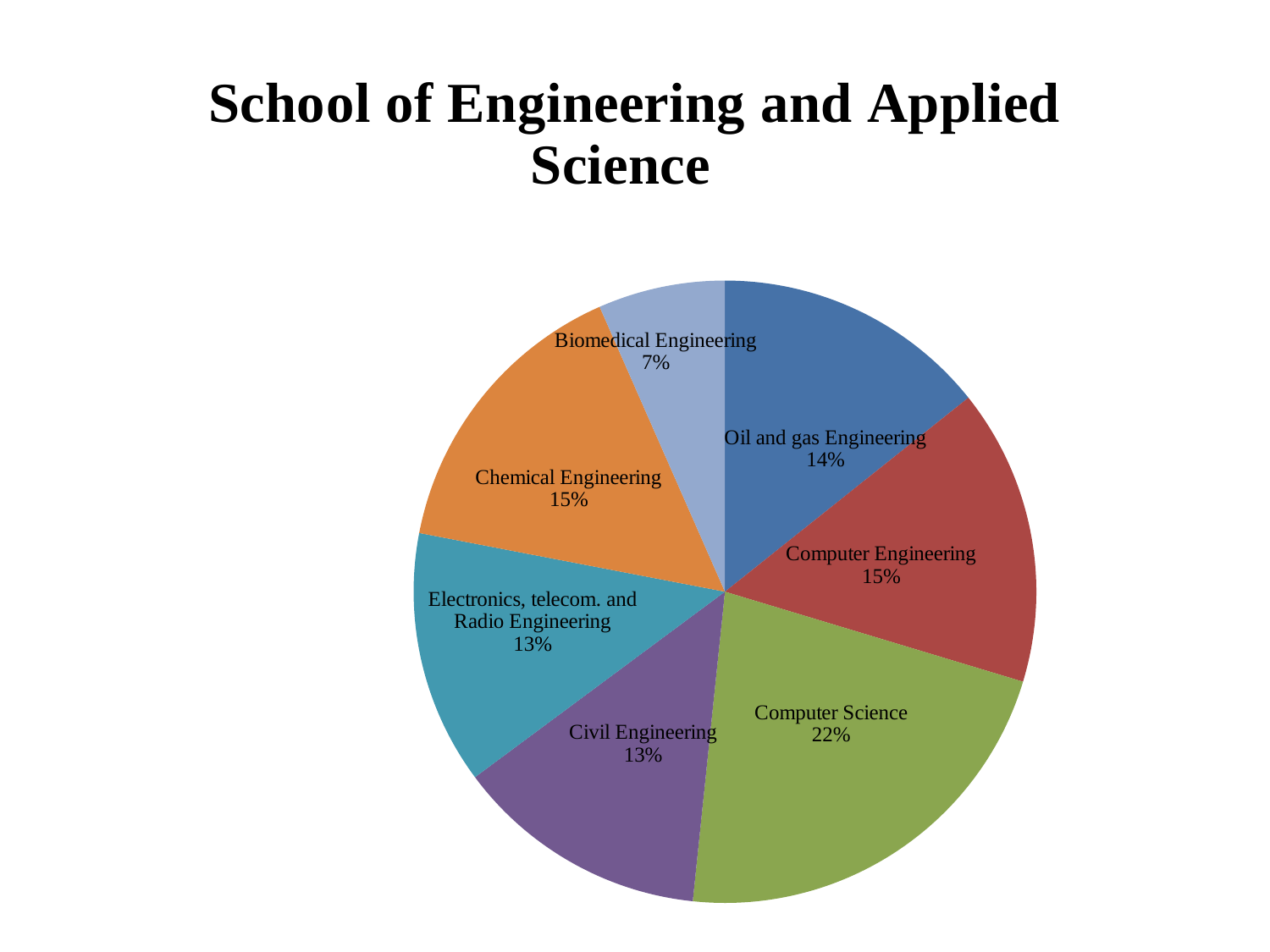
What is the title of the slide containing the chart? School of Engineering and Applied Science What is the value shown for Oil and gas Engineering? 14% What share of the pie does Computer Science hold? 22% Which is larger, the share for Computer Science or the share for Chemical Engineering? Computer Science Which category has the smallest slice of the pie? Biomedical Engineering How many categories are shown in the pie chart? 7 What is the difference between the shares of Computer Science and Biomedical Engineering? 15% What is the value shown for Biomedical Engineering? 7% What is the difference between the shares of Chemical Engineering and Civil Engineering? 2% What is the value shown for Electronics, telecom. and Radio Engineering? 13% Which category has the largest slice of the pie? Computer Science What kind of chart is shown on the slide? pie chart